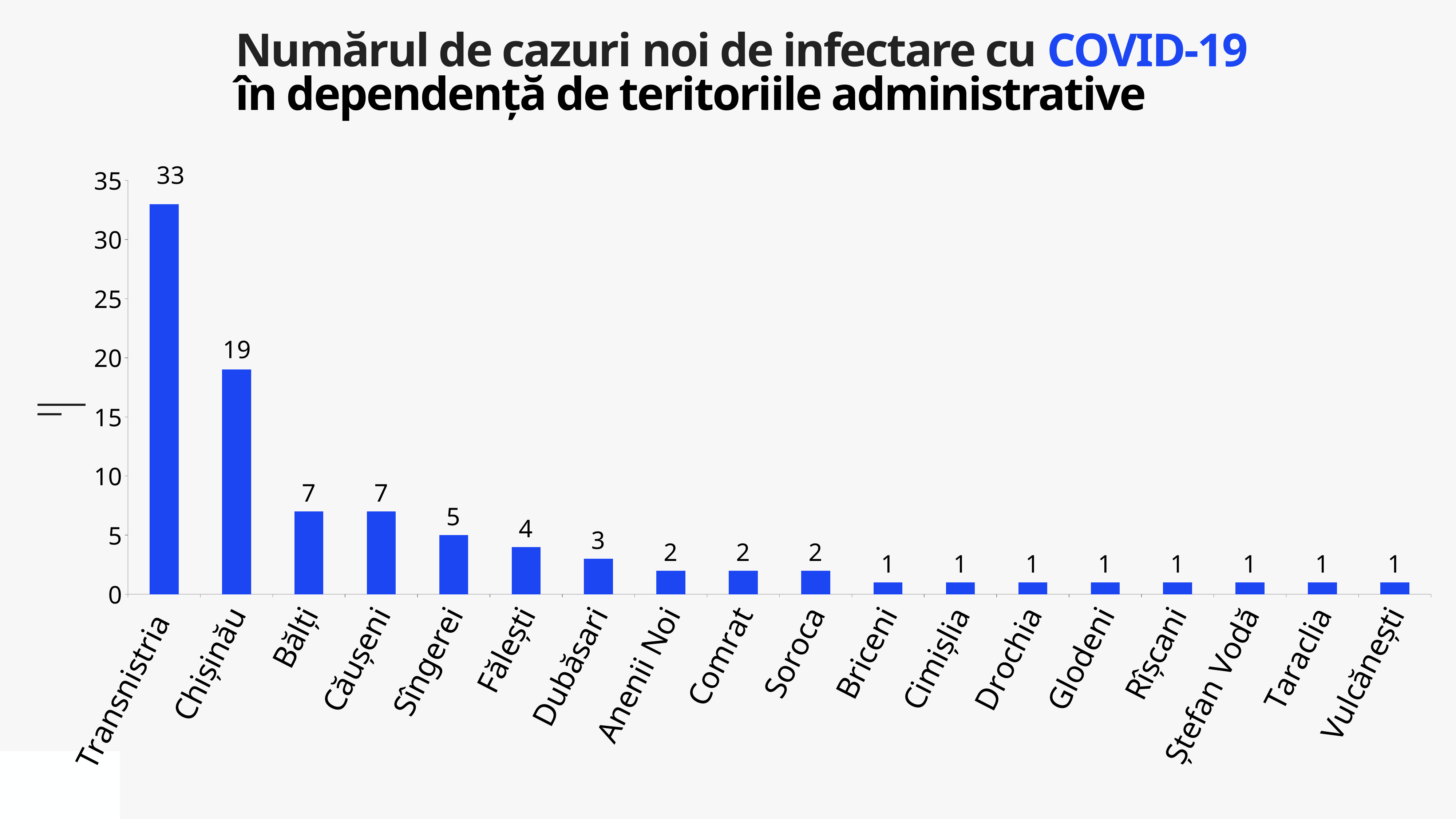
What is the value for Sîngerei? 5 What is the value for Chișinău? 19 What is the difference between the values for Bălți and Fălești? 3 How many categories are shown on the x axis? 18 What is the value for Dubăsari? 3 Which category has the highest value? Transnistria What is the value for Transnistria? 33 Do the values rise or fall from left to right along the x axis? fall Which is larger, the value for Căușeni or the value for Soroca? Căușeni What kind of chart is shown on the slide? bar chart Is the value for Chișinău greater or less than 15? greater What is the difference between the values for Transnistria and Chișinău? 14